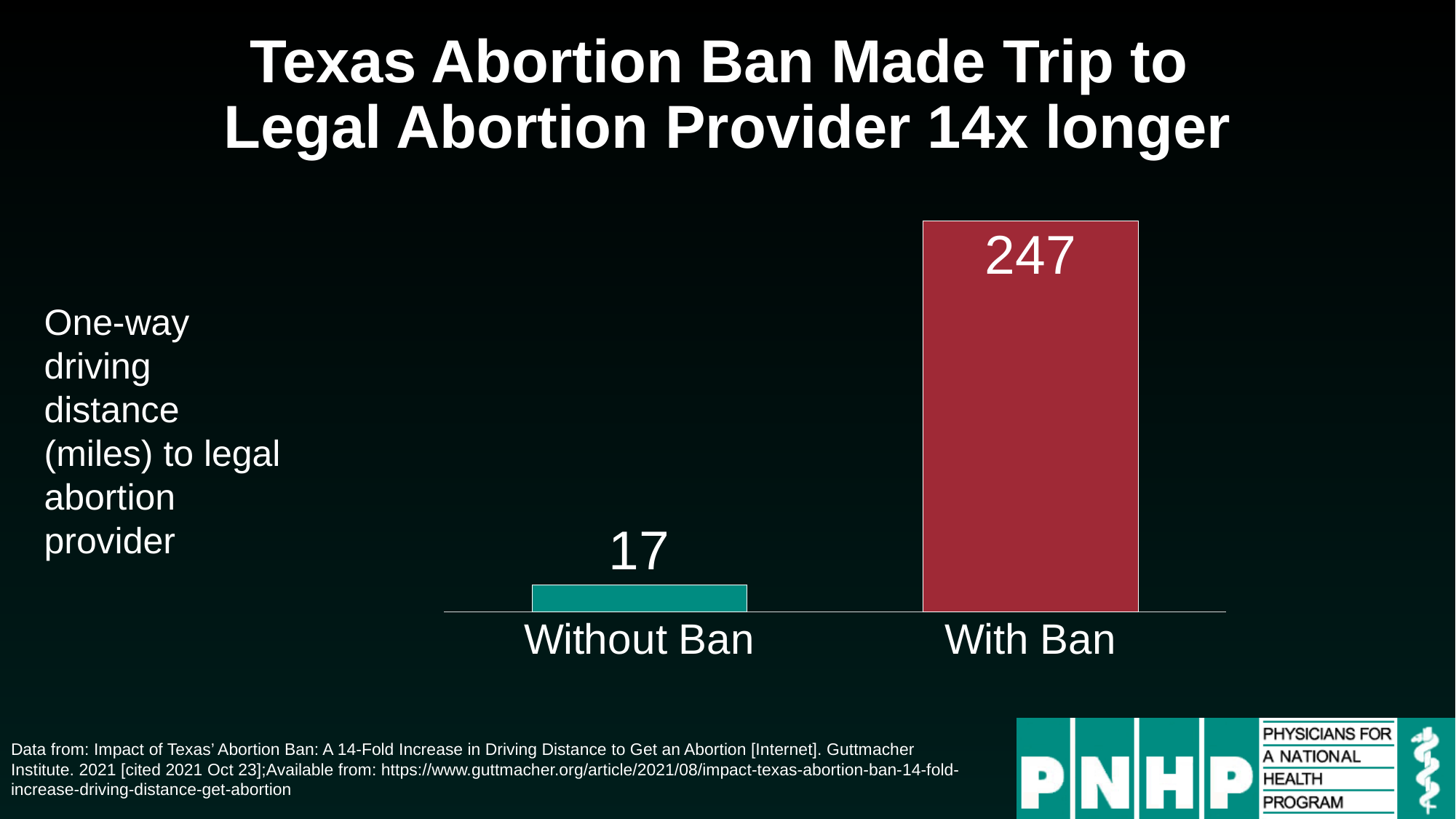
Which category has the lower driving distance? Without Ban Which category has the higher driving distance, Without Ban or With Ban? With Ban What is the one-way driving distance to a legal abortion provider without the ban? 17 What kind of chart is shown on the slide? bar chart What unit is the driving distance measured in, according to the axis label? miles What is the one-way driving distance to a legal abortion provider with the ban? 247 Is the value for Without Ban larger or smaller than the value for With Ban? smaller What is the difference in driving distance between With Ban and Without Ban? 230 Do the values rise or fall from Without Ban to With Ban? rise What is the title of the slide? Texas Abortion Ban Made Trip to Legal Abortion Provider 14x longer How many categories are shown on the chart? 2